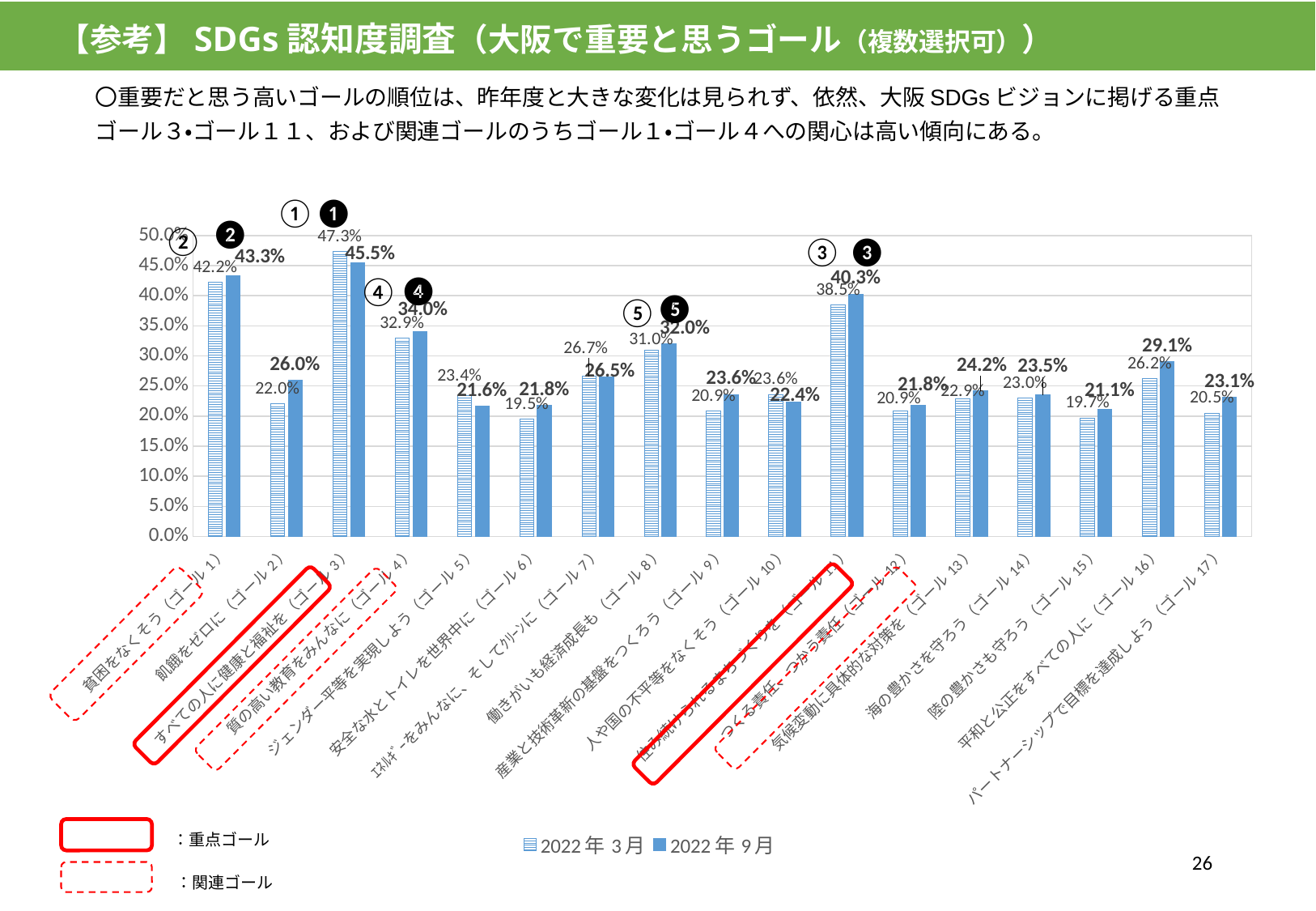
What is the 2022年 3月 value for すべての人に健康と福祉を（ゴール3）? 47.3% What is the 2022年 9月 value for 貧困をなくそう（ゴール1）? 43.3% How many goals (categories) are shown on the x axis? 17 How many series does the legend list? 2 Which goal has the lowest 2022年 3月 value? 安全な水とトイレを世界中に（ゴール6） What kind of chart is shown on the slide? Bar chart What is the difference between the 2022年 9月 and 2022年 3月 values for 飢餓をゼロに（ゴール2）? 4.0% What is the 2022年 9月 value for 住み続けられるまちづくりを（ゴール11）? 40.3% What are the two series named in the legend? 2022年 3月 and 2022年 9月 What is the 2022年 3月 value for 平和と公正をすべての人に（ゴール16）? 26.2% For 質の高い教育をみんなに（ゴール4）, which is larger: the 2022年 3月 value or the 2022年 9月 value? 2022年 9月 Which goal has the highest 2022年 9月 value? すべての人に健康と福祉を（ゴール3）